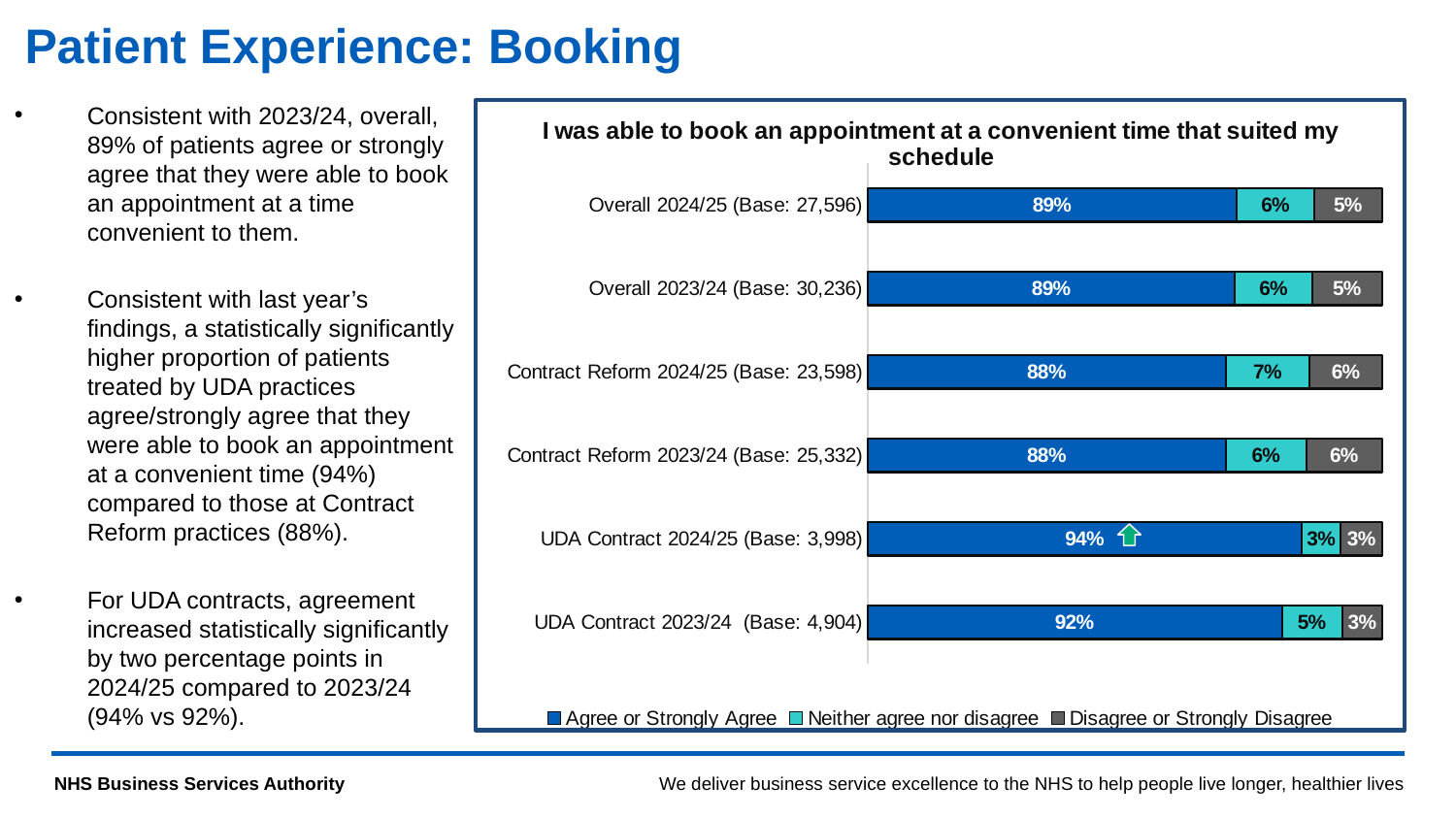
What is the title of the chart? I was able to book an appointment at a convenient time that suited my schedule Which category has the highest 'Agree or Strongly Agree' percentage? UDA Contract 2024/25 Which categories have the lowest 'Agree or Strongly Agree' percentage? Contract Reform 2024/25 and Contract Reform 2023/24 What is the 'Neither agree nor disagree' value for Contract Reform 2024/25? 7% What percentage of Overall 2024/25 respondents agree or strongly agree that they were able to book an appointment at a convenient time? 89% What is the difference in 'Agree or Strongly Agree' between UDA Contract 2024/25 and Contract Reform 2024/25? 6 percentage points Which has a larger 'Neither agree nor disagree' share: UDA Contract 2023/24 or UDA Contract 2024/25? UDA Contract 2023/24 How many categories (bars) are shown in the chart? 6 What is the base (number of respondents) for Overall 2023/24? 30,236 How many series does the legend list? 3 What is the 'Disagree or Strongly Disagree' value for UDA Contract 2023/24? 3% What type of chart is shown on the slide? Stacked bar chart